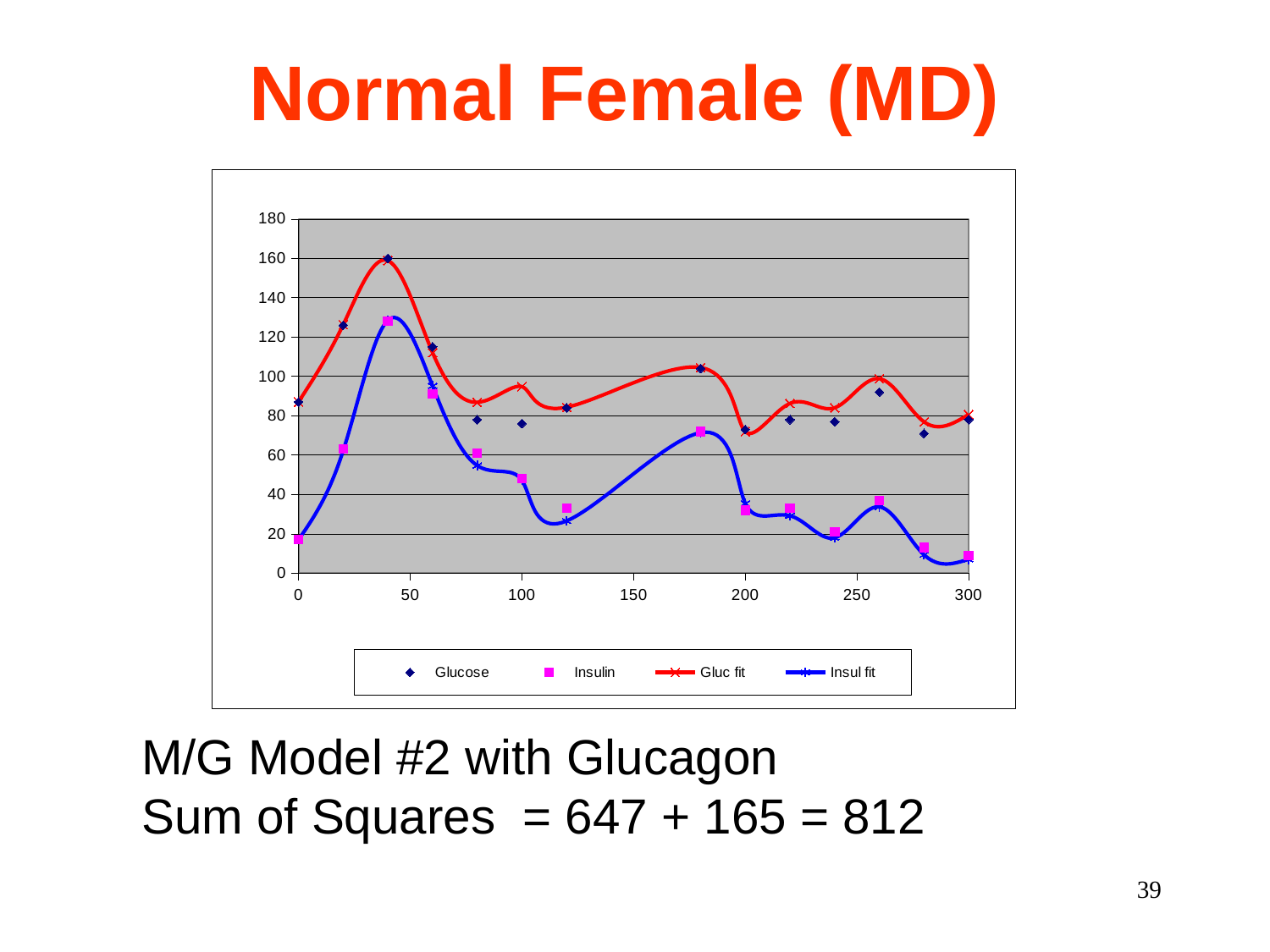
Is the Glucose value at x = 0 greater or less than 80? greater What colour is the Insul fit line in the legend? blue Which series reaches the highest value on the chart? Glucose What kind of chart is shown on the slide? line chart Is the Insulin value at x = 200 greater or less than 40? less Is the Glucose value at x = 200 greater or less than 80? less What colour is the Gluc fit line in the legend? red At x = 0, which is larger, the Glucose value or the Insulin value? Glucose How many series does the legend list? 4